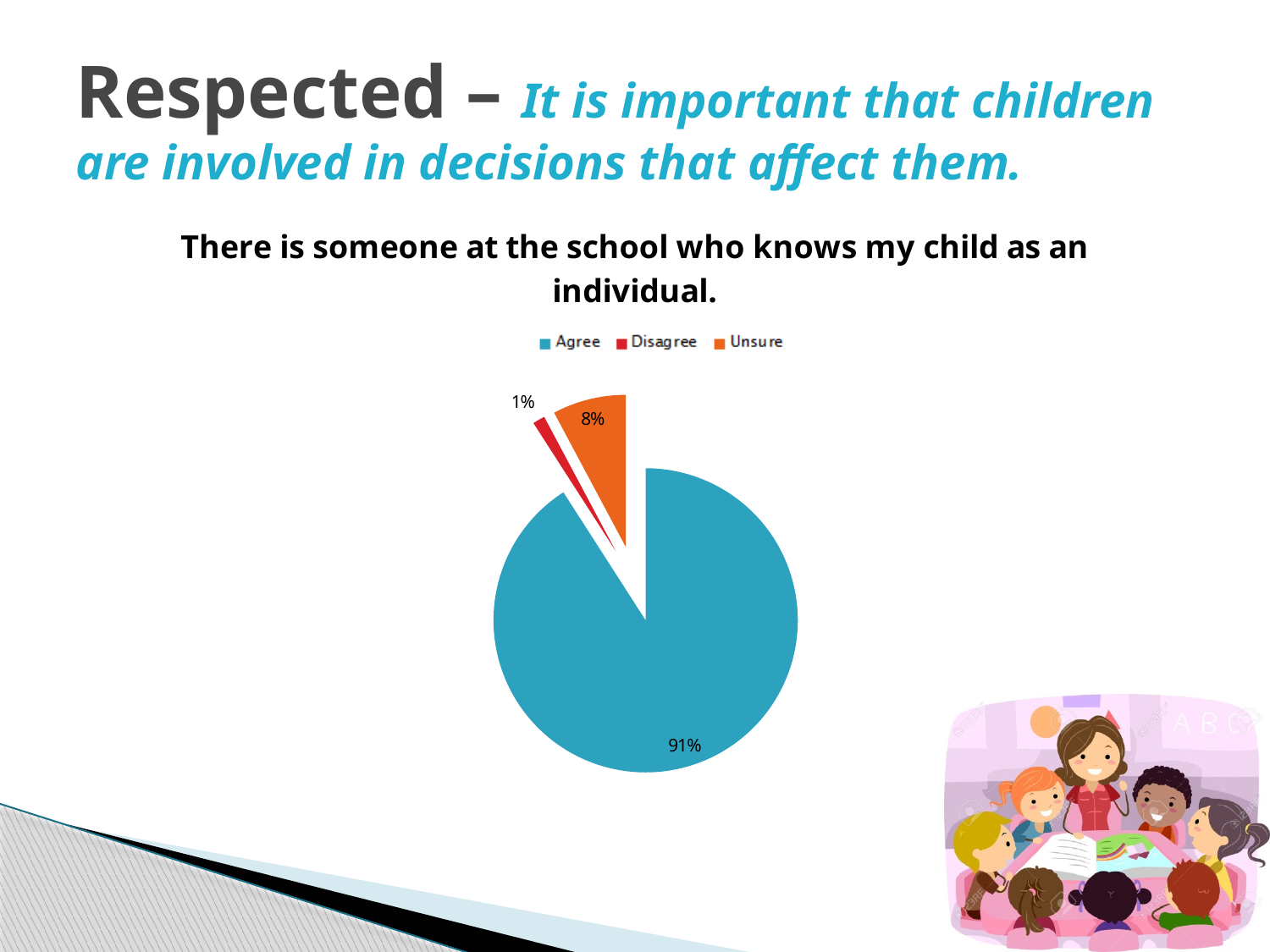
What kind of chart is shown on the slide? Pie chart Which response has the smallest share of the pie? Disagree Which response has the largest share of the pie? Agree Which is larger, the Unsure share or the Disagree share? Unsure What colour is the Agree slice? Blue What is the difference in percentage points between Agree and Unsure? 83 What is the difference in percentage points between Unsure and Disagree? 7 What percentage of respondents disagree? 1% How many entries does the legend list? 3 What percentage of respondents are unsure? 8% How many slices does the pie chart have? 3 What percentage of respondents agree that there is someone at the school who knows their child as an individual? 91%